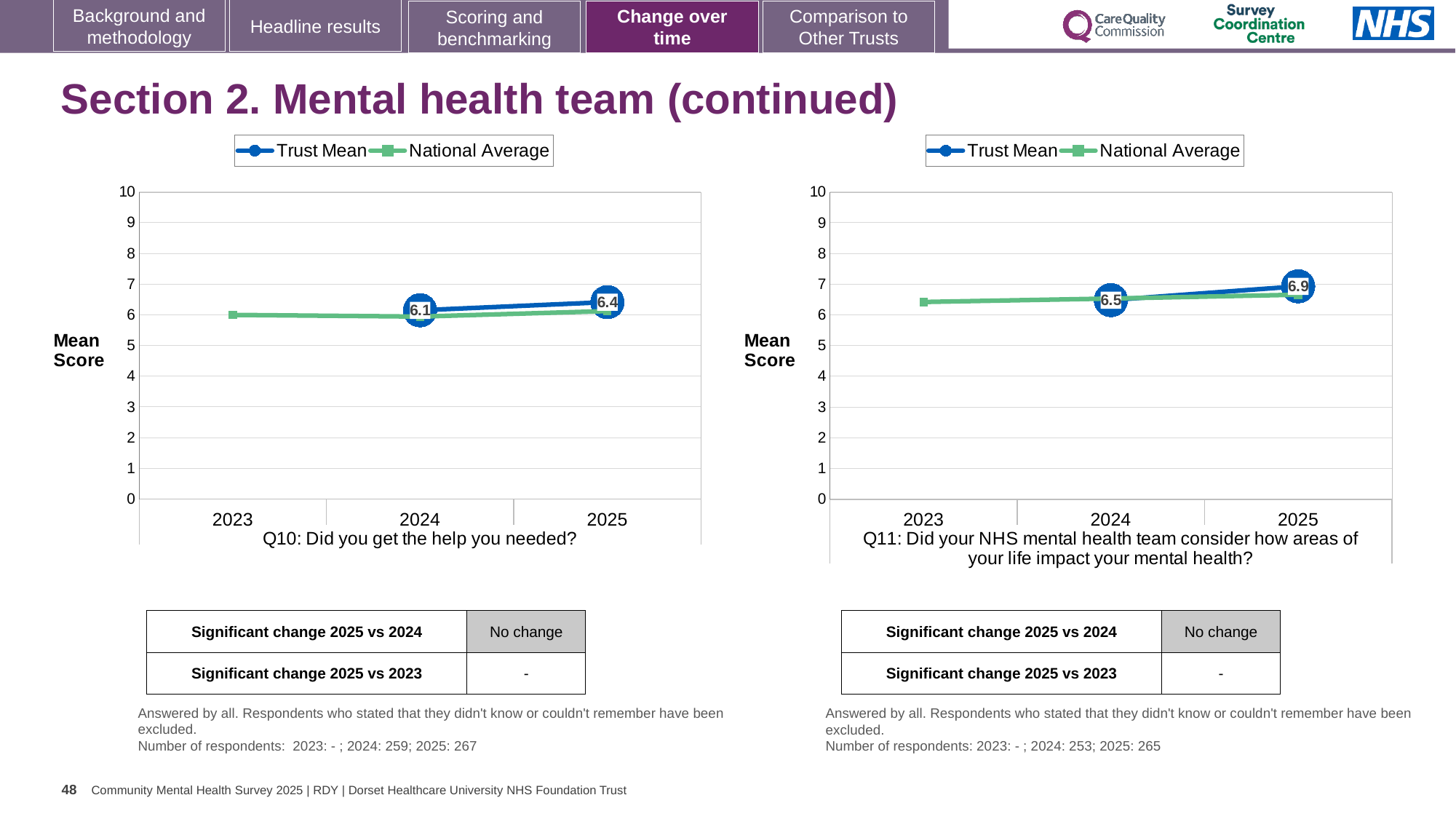
What kind of chart is the Q10 chart on the left? line chart How many series does the legend of the Q11 chart (right) list? 2 Which chart has the higher Trust Mean for 2025, the Q10 chart (left) or the Q11 chart (right)? Q11 chart (right) In the Q10 chart (left), what is the Trust Mean for 2025? 6.4 In the Q11 chart (right), what is the Trust Mean for 2024? 6.5 In the Q10 chart (left), by how much did the Trust Mean change from 2024 to 2025? 0.3 In the Q11 chart (right), by how much did the Trust Mean change from 2024 to 2025? 0.4 In the Q11 chart (right), is the National Average for 2023 greater or less than 5? greater How many years are shown on the x axis of the Q10 chart (left)? 3 In the Q11 chart (right), what is the Trust Mean for 2025? 6.9 In the Q11 chart (right), does the Trust Mean rise or fall from 2024 to 2025? rise In the Q10 chart (left), what is the Trust Mean for 2024? 6.1